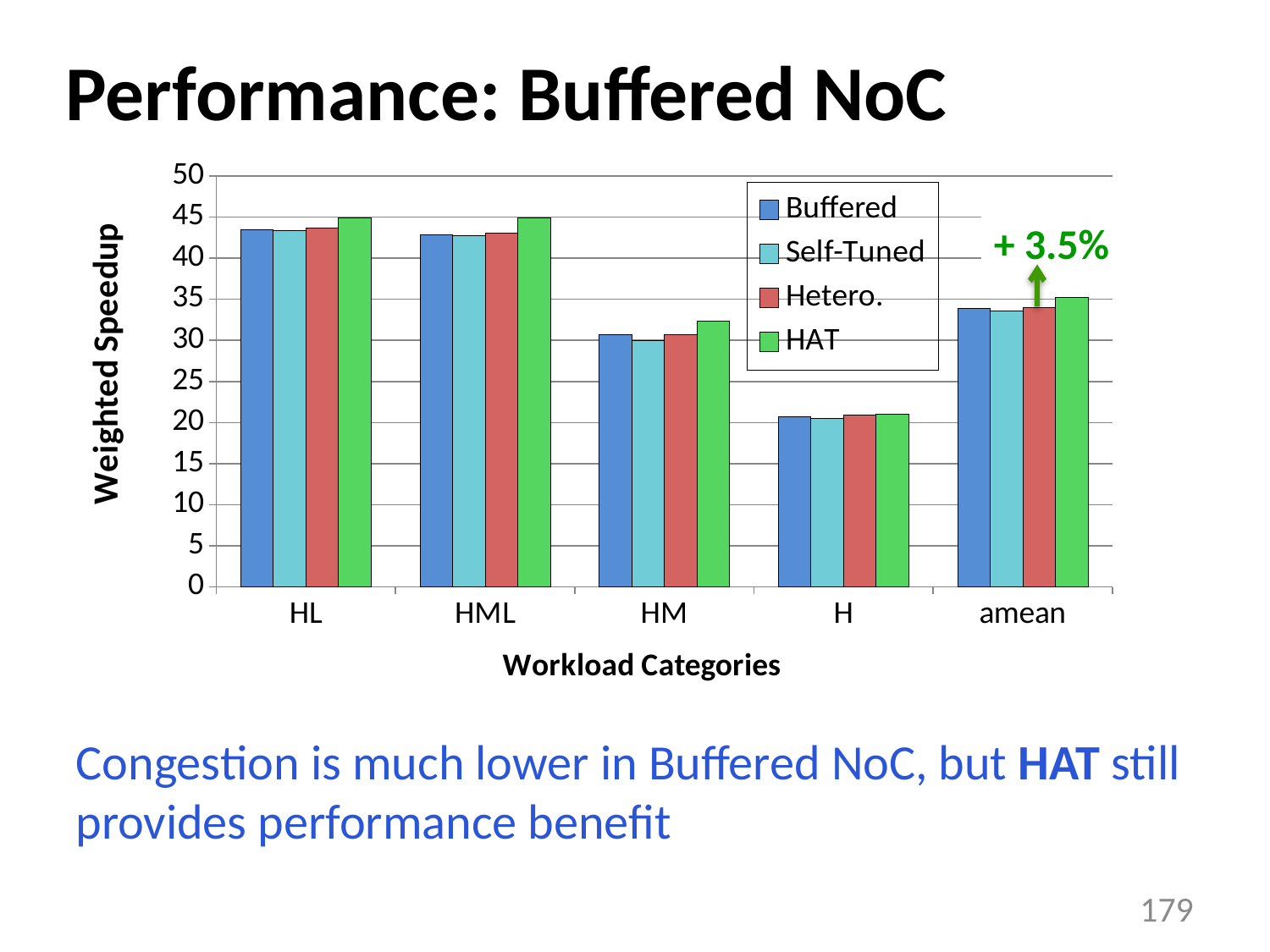
Is the Hetero. value for amean greater or less than 30? greater What is the label of the y axis? Weighted Speedup How many series does the legend list? 4 How many workload categories are shown on the x axis? 5 Do the Buffered values rise or fall going from HL to H along the x axis? fall What percentage improvement is annotated above the amean group? + 3.5% Which workload category has the lowest weighted speedup for the Buffered series? H For the HM category, which is larger: the HAT bar or the Self-Tuned bar? HAT What kind of chart is shown on the slide? bar chart Is the Self-Tuned value for HM greater or less than 25? greater Is the Buffered value for HL greater or less than 40? greater